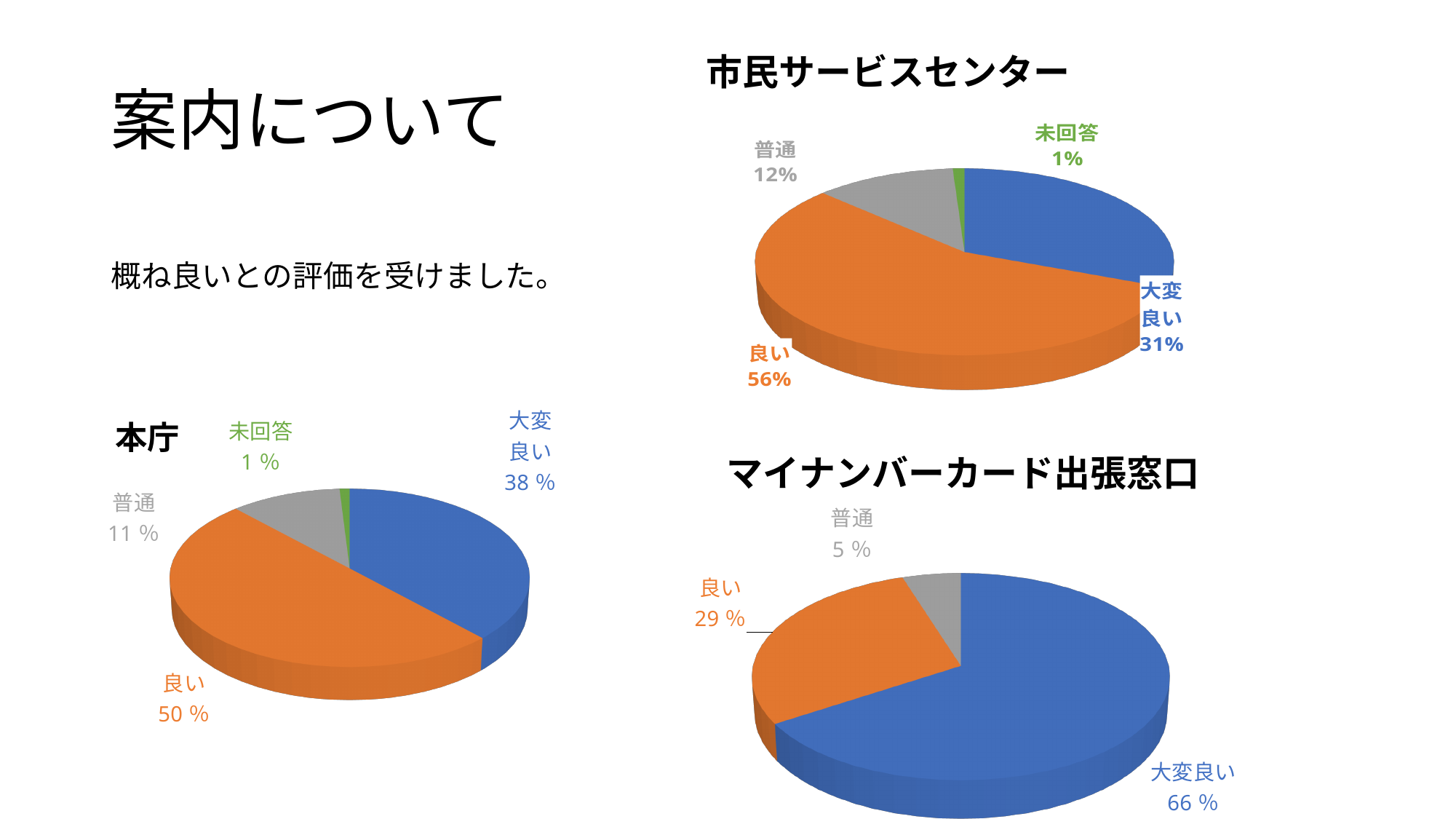
In the 市民サービスセンター chart, what is the difference between the 良い and 大変良い shares? 25% What kind of chart is the 本庁 chart? Pie chart In the マイナンバーカード出張窓口 chart, which category has the smallest slice? 普通 How many charts are on the slide? 3 In the 市民サービスセンター chart, which category has the largest slice? 良い How many categories are shown in the 本庁 chart? 4 In the 市民サービスセンター chart, which category has the smallest slice? 未回答 In the 本庁 chart, which is larger, 良い or 大変良い? 良い In the 市民サービスセンター chart, what share is labelled for 良い? 56% In the マイナンバーカード出張窓口 chart, what share is labelled for 大変良い? 66 % In the 本庁 chart, what share is labelled for 大変良い? 38 % How many categories are shown in the マイナンバーカード出張窓口 chart? 3